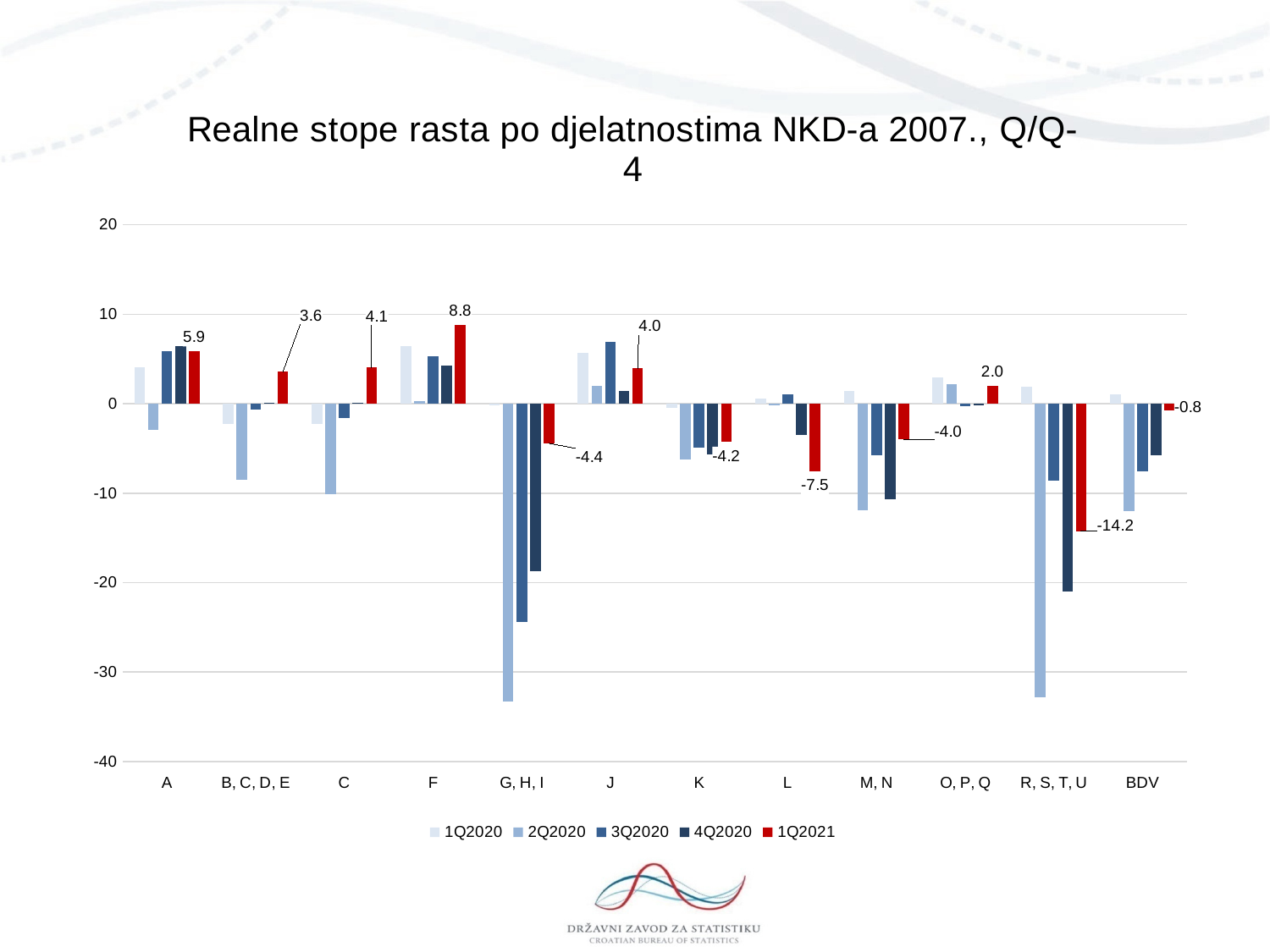
What kind of chart is shown on the slide? bar chart What is the 1Q2021 value for category R, S, T, U? -14.2 What is the 1Q2021 value for category F? 8.8 What colour represents the 1Q2021 series? red Is the 2Q2020 value for G, H, I greater or less than -30? less What is the difference between the 1Q2021 values for F and A? 2.9 How many series does the legend list? 5 Which category has the highest 1Q2021 value? F What is the 1Q2021 value for category L? -7.5 How many categories are shown on the x axis? 12 Which has the larger 1Q2021 value, category A or category C? A Which category has the lowest 1Q2021 value? R, S, T, U